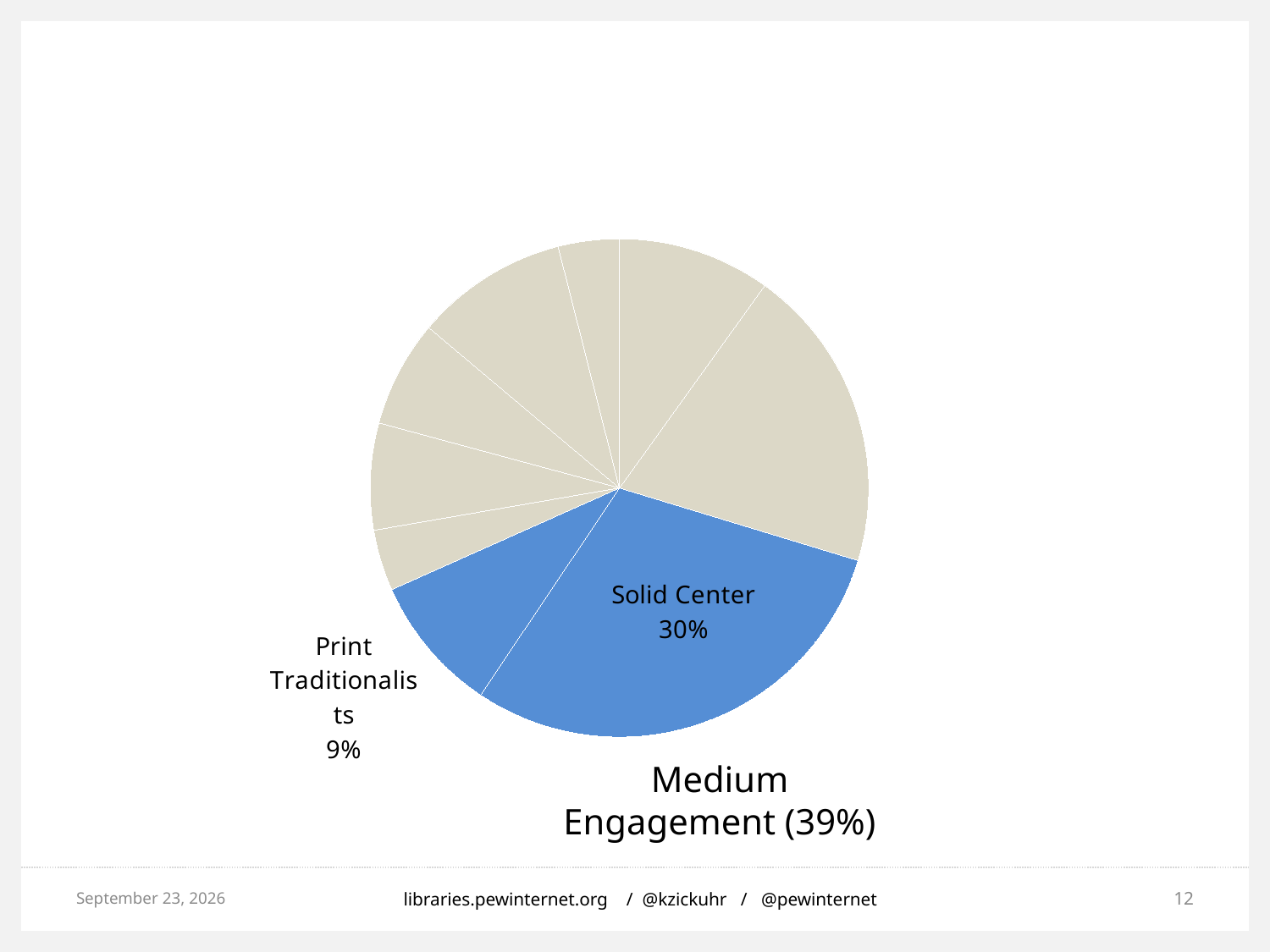
What share of the pie does the Solid Center slice represent? 30% What percentage is shown for the Print Traditionalists slice? 9% By how many percentage points does Solid Center exceed Print Traditionalists? 21 percentage points What percentage is shown for the Solid Center slice? 30% Of the two labelled slices, which has the lower percentage? Print Traditionalists Which slice is larger, Solid Center or Print Traditionalists? Solid Center What combined percentage is given for Medium Engagement? 39% What text label appears below the pie chart? Medium Engagement (39%) What colour are the Solid Center and Print Traditionalists slices? blue What kind of chart is shown on the slide? pie chart Of the two labelled slices, which has the higher percentage? Solid Center How many slices does the pie chart have? 9